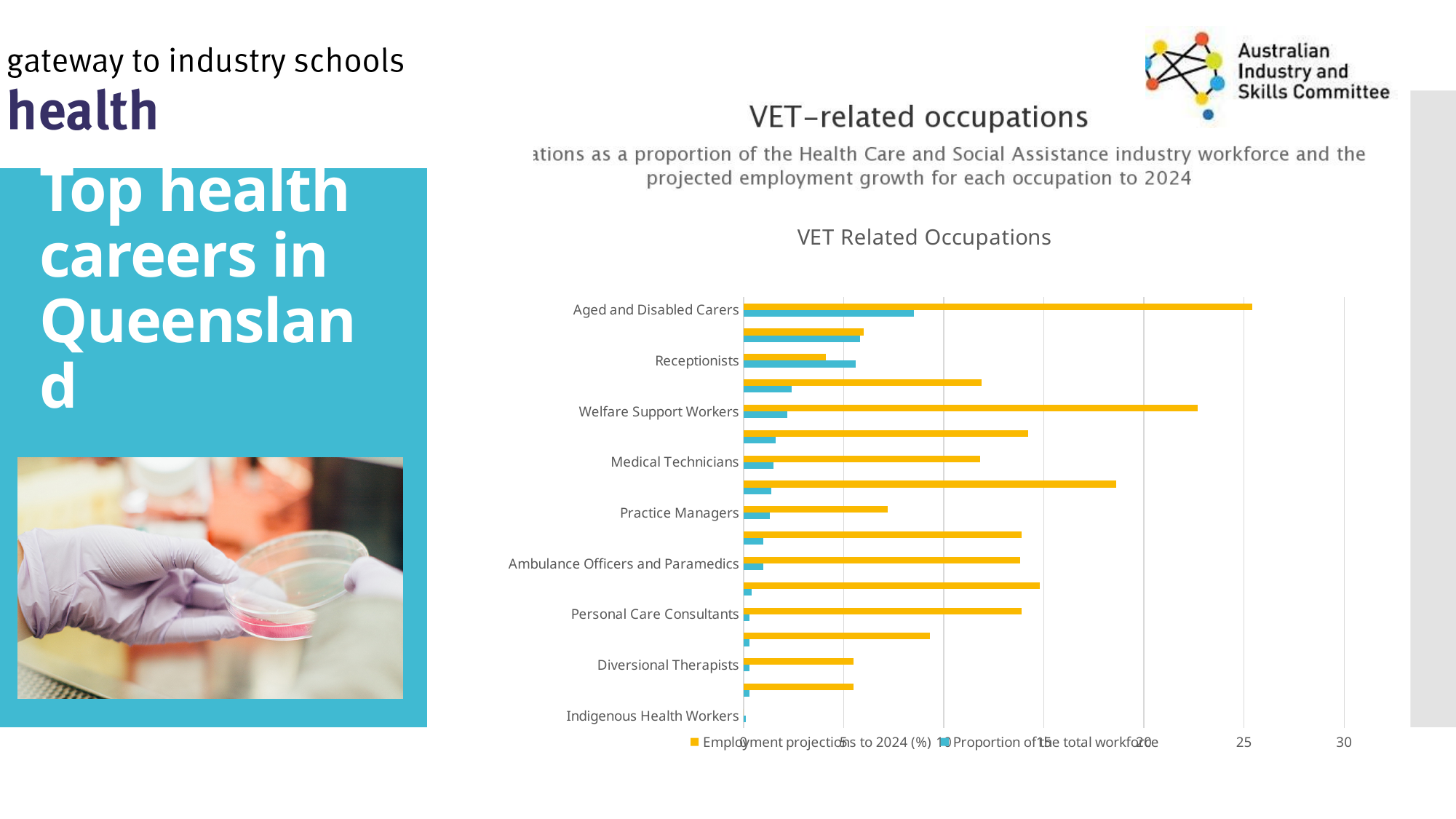
Is the employment projection to 2024 (%) for Welfare Support Workers greater or less than 20? greater What kind of chart is shown on the slide? bar chart Is the employment projection to 2024 (%) for Receptionists greater or less than 5? less Which labelled occupation has the highest employment projection to 2024 (%)? Aged and Disabled Carers Which has the larger employment projection to 2024 (%): Welfare Support Workers or Medical Technicians? Welfare Support Workers Which series is shown in orange in the chart? Employment projections to 2024 (%) Is the employment projection to 2024 (%) for Ambulance Officers and Paramedics greater or less than 10? greater Which labelled occupation has the highest proportion of the total workforce? Aged and Disabled Carers What is the title of the chart? VET Related Occupations Which labelled occupation has the lowest employment projection to 2024 (%)? Indigenous Health Workers How many series does the chart legend list? 2